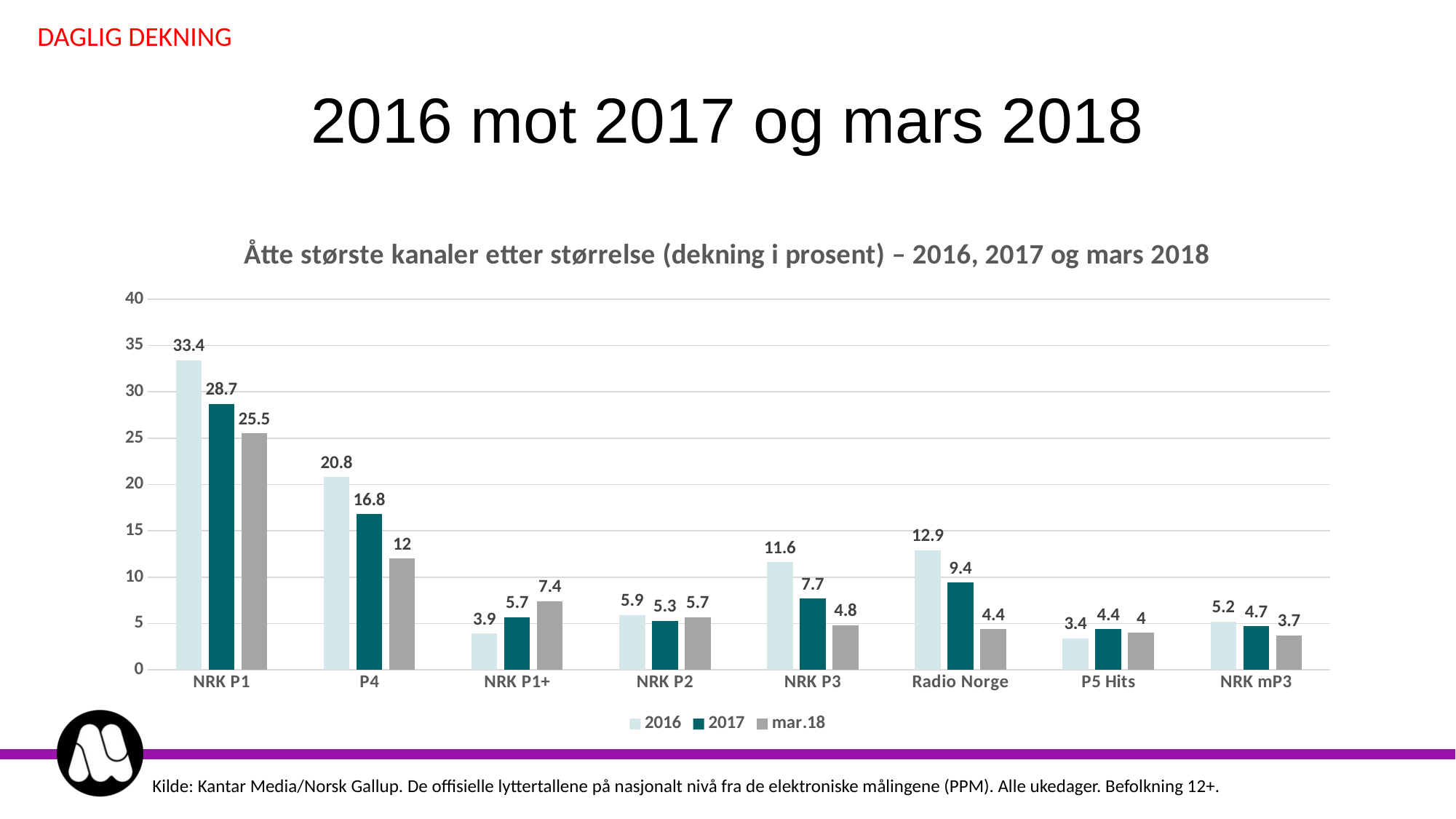
Which is larger for NRK P3: the 2016 value or the mar.18 value? 2016 What is the 2017 value for Radio Norge? 9.4 What is the title of the chart? Åtte største kanaler etter størrelse (dekning i prosent) – 2016, 2017 og mars 2018 What is the 2016 value for NRK P1? 33.4 Which channel has the highest 2017 value? NRK P1 Is the 2016 value for P4 greater or less than 20? greater What is the mar.18 value for P4? 12 What kind of chart is shown? bar chart Which channel has the lowest 2016 value? P5 Hits What is the difference between the 2016 and 2017 values for NRK P1? 4.7 How many series does the legend list? 3 How many channels are shown on the x axis? 8